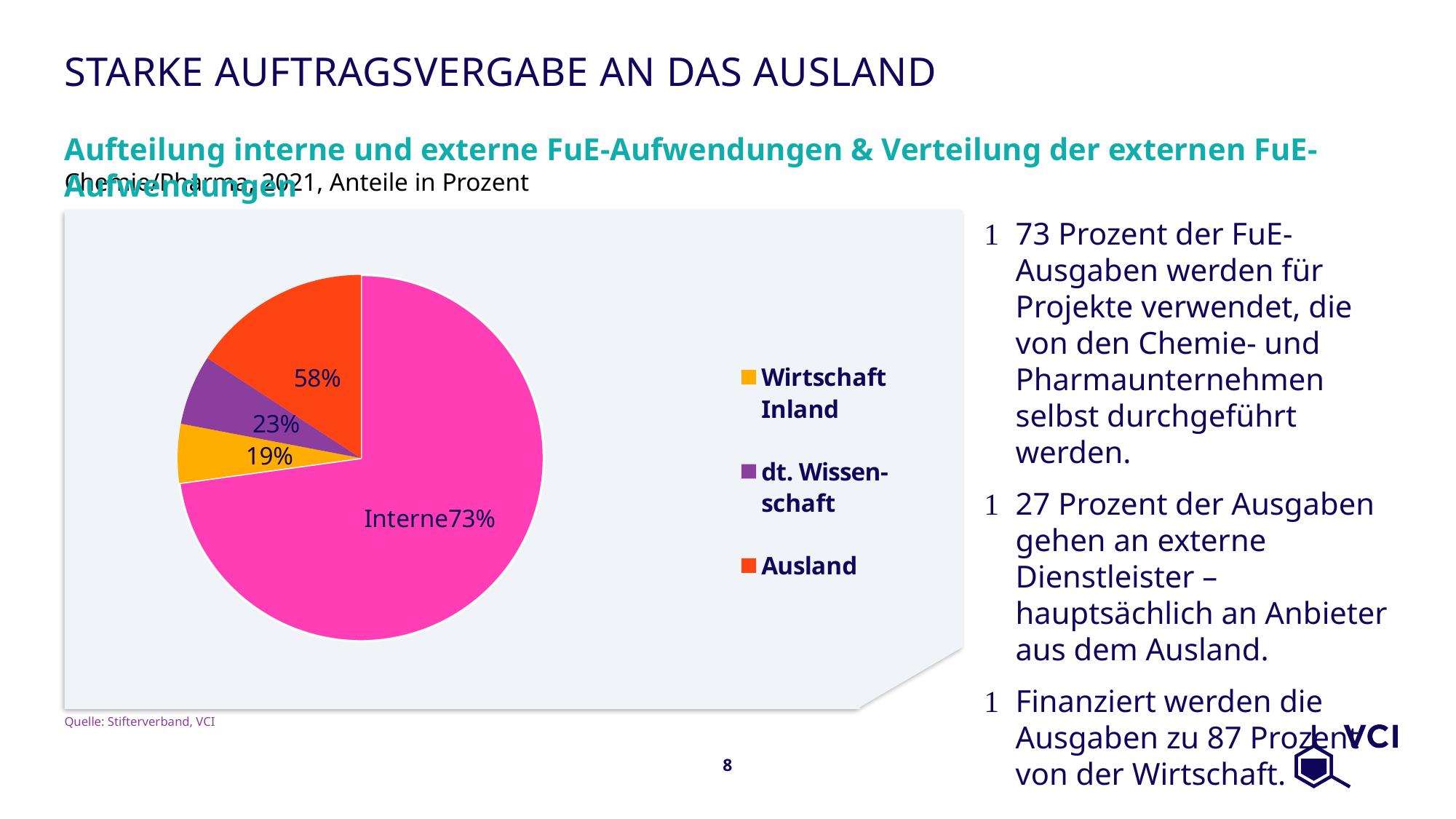
What percentage label is shown on the Ausland slice? 58% How many slices does the pie chart have? 4 Which has the larger labelled percentage, Ausland or dt. Wissenschaft? Ausland How many entries does the legend of the pie chart list? 3 What percentage label is shown on the dt. Wissenschaft slice? 23% What kind of chart is shown on the slide? pie chart Which slice of the pie chart is the largest? Interne Which of the three external slices (Wirtschaft Inland, dt. Wissenschaft, Ausland) has the smallest labelled percentage? Wirtschaft Inland Which of the three external slices has the largest labelled percentage? Ausland What is the difference in percentage points between the Ausland label (58%) and the dt. Wissenschaft label (23%)? 35 percentage points What percentage label is shown on the Wirtschaft Inland slice? 19% What percentage is shown for the Interne slice of the pie chart? 73%